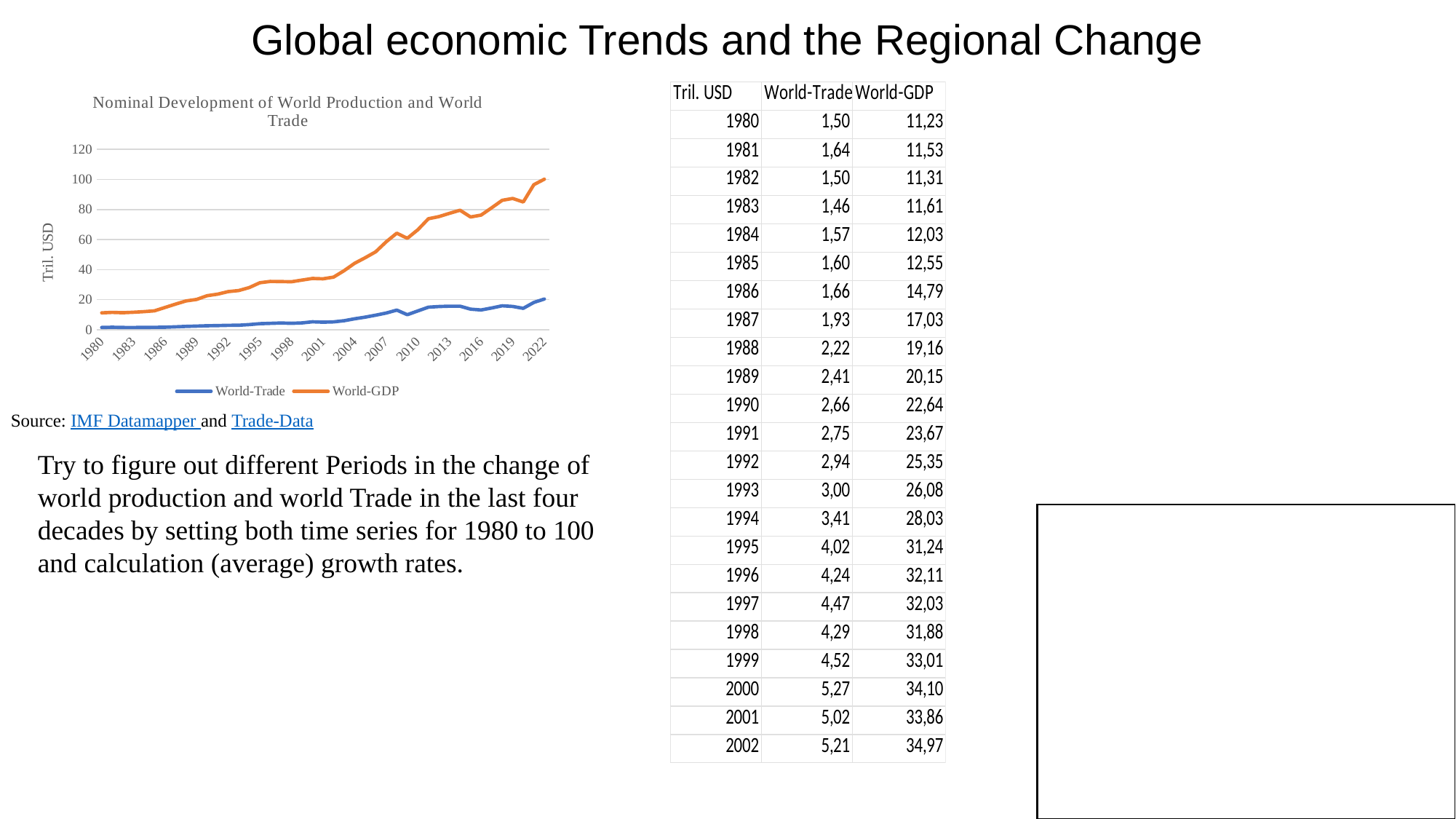
How many series does the chart's legend list? 2 Is the value for World-GDP in 1995 greater or less than 40? less Is the value for World-GDP in 2019 greater or less than 80? greater According to the table on the slide, what is the World-GDP value for 1990? 22,64 Is the value for World-Trade in 2022 greater or less than 40? less What type of chart is shown on the slide? line chart What is the title of the chart? Nominal Development of World Production and World Trade Does the World-GDP line generally rise or fall from 1980 to 2022? rise What is the label on the chart's vertical axis? Tril. USD According to the table on the slide, what is the World-Trade value for 2000? 5,27 Does the World-Trade line generally rise or fall from 1980 to 2022? rise In 2022, which series has the larger value, World-Trade or World-GDP? World-GDP